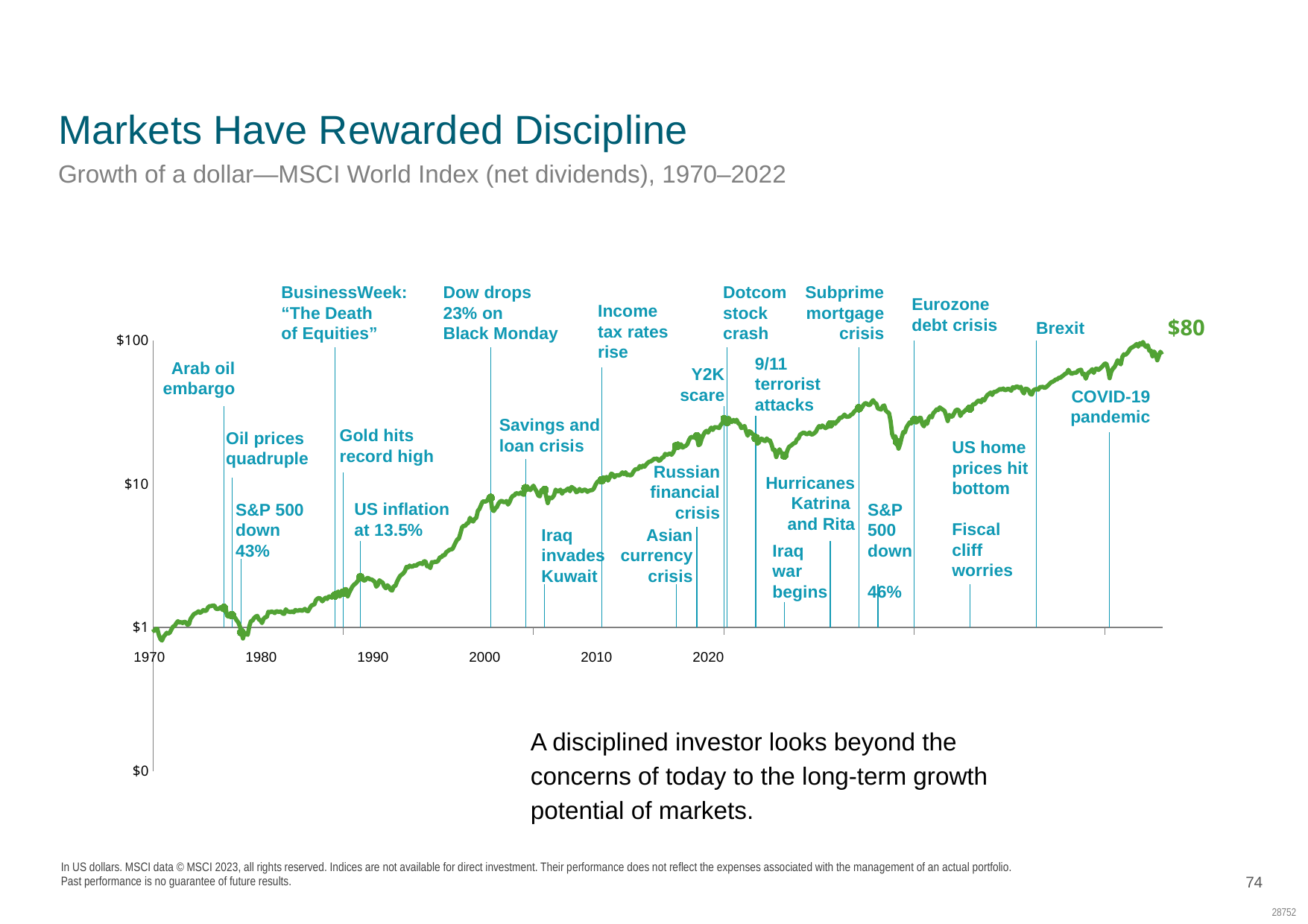
Is the value of the line in 1980 greater or less than $10? less Is the value of the line in 1990 greater or less than $1? greater What kind of chart is shown on the slide? Line chart What is the ending value of the dollar invested in the MSCI World Index, as labeled at the end of the line? $80 How many year labels are shown on the x axis? 6 Is the value of the line at its 2022 endpoint greater or less than $100? less Does the growth of a dollar generally rise or fall from 1970 to 2022? Rise What is the starting value of the line in 1970? $1 What is the highest dollar value labeled on the y axis? $100 What index does the chart track, according to the subtitle? MSCI World Index (net dividends)